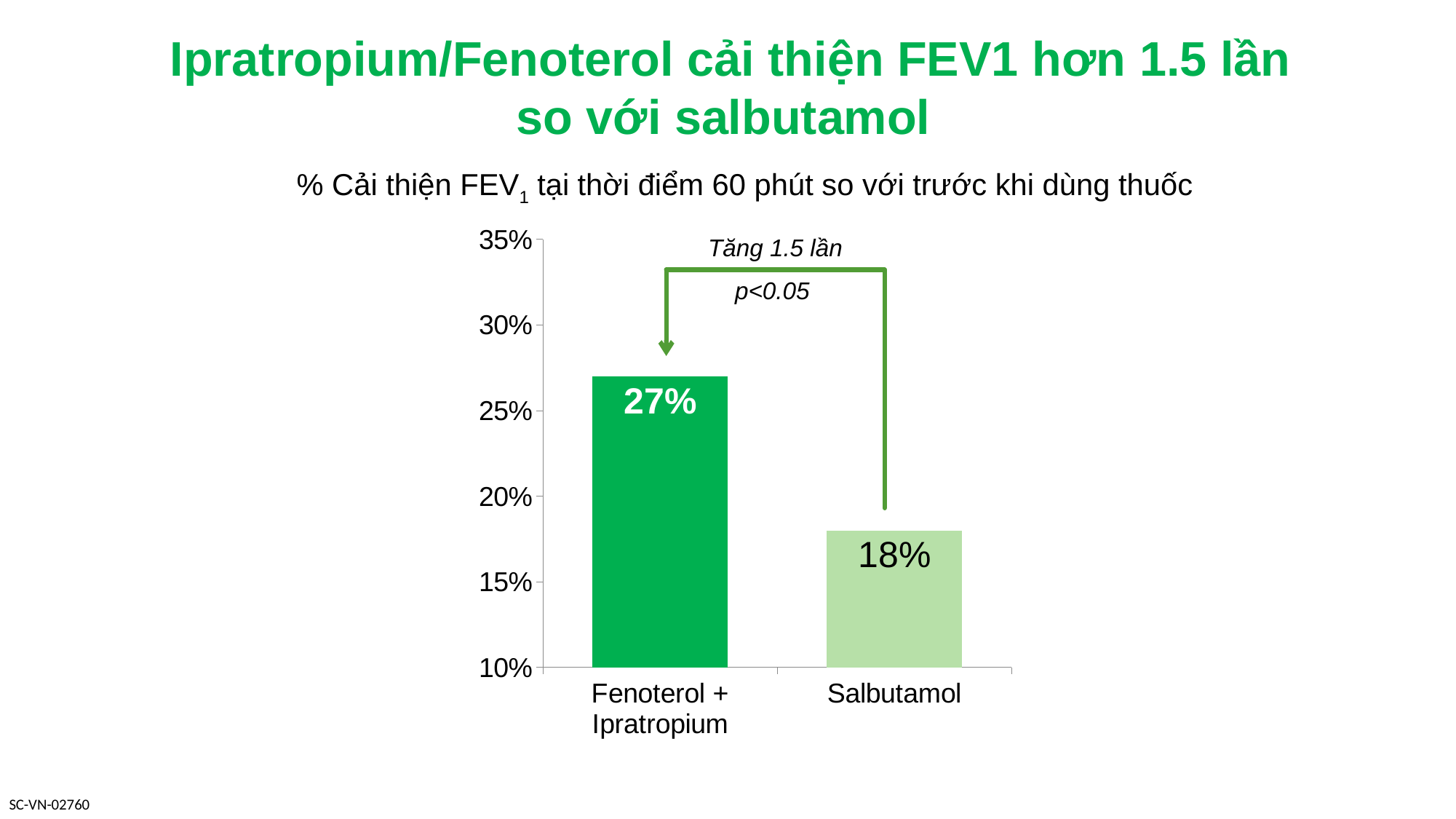
What is the value for Fenoterol + Ipratropium? 27% Which is larger, the value for Fenoterol + Ipratropium or the value for Salbutamol? Fenoterol + Ipratropium Is the value for Salbutamol greater or less than 20%? less Which category has the lowest value? Salbutamol What is the difference between the values for Fenoterol + Ipratropium and Salbutamol? 9% What is the highest value shown on the y axis? 35% What is the value for Salbutamol? 18% Is the value for Fenoterol + Ipratropium greater or less than 25%? greater What kind of chart is shown on the slide? bar chart Which category has the highest value? Fenoterol + Ipratropium What p-value is annotated between the two bars? p<0.05 How many categories are shown on the x axis? 2